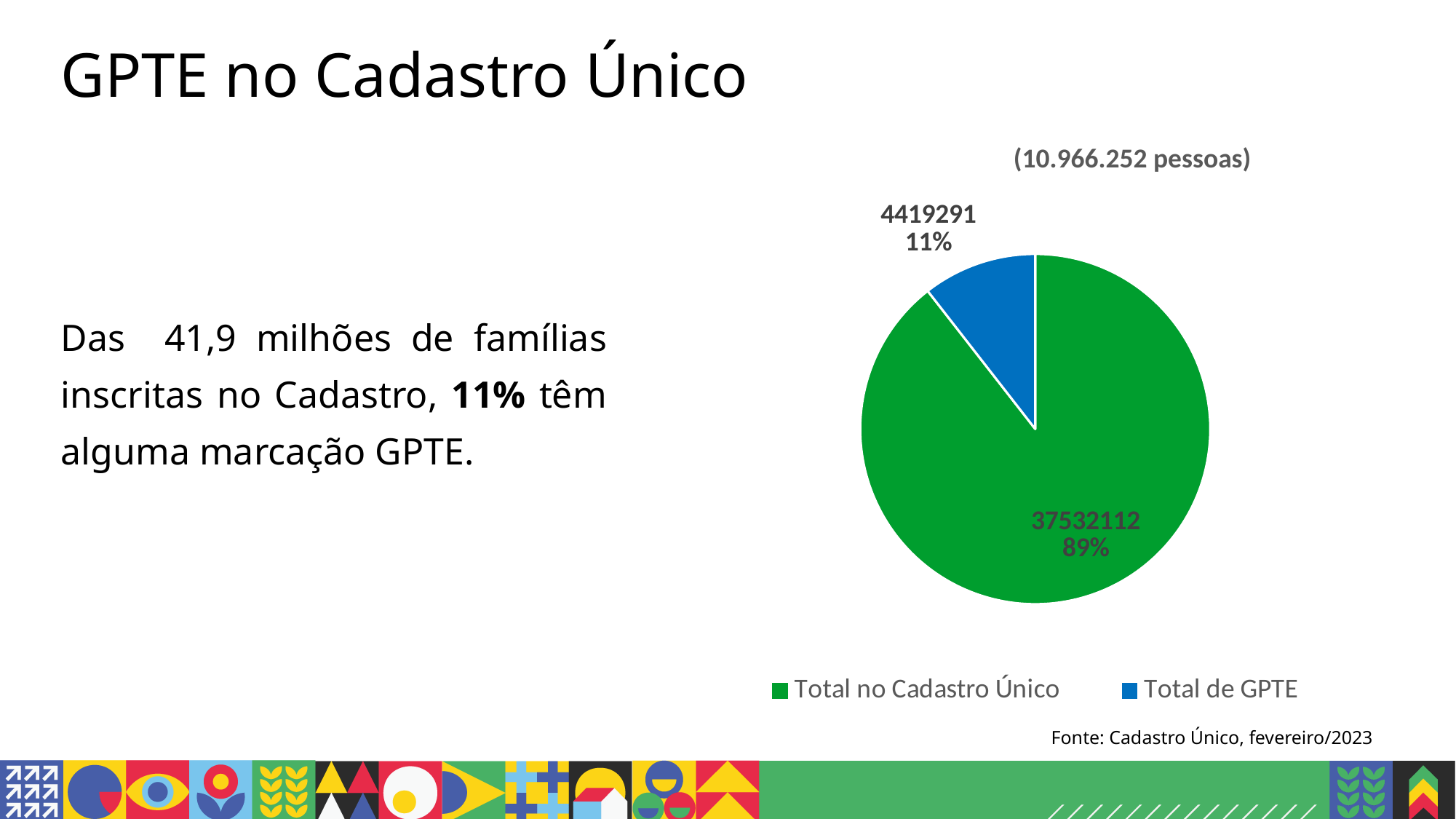
What share of the pie does Total no Cadastro Único represent? 89% What is the value for Total de GPTE in the pie chart? 4419291 What is the value for Total no Cadastro Único in the pie chart? 37532112 Which is larger, Total no Cadastro Único or Total de GPTE? Total no Cadastro Único What is the difference between the values for Total no Cadastro Único and Total de GPTE? 33112821 What share of the pie does Total de GPTE represent? 11% How many entries does the chart legend list? 2 Which slice of the pie chart is the smallest? Total de GPTE Which slice of the pie chart is the largest? Total no Cadastro Único What kind of chart is shown on the slide? pie chart What colour is the Total de GPTE slice in the pie chart? blue How many slices does the pie chart have? 2